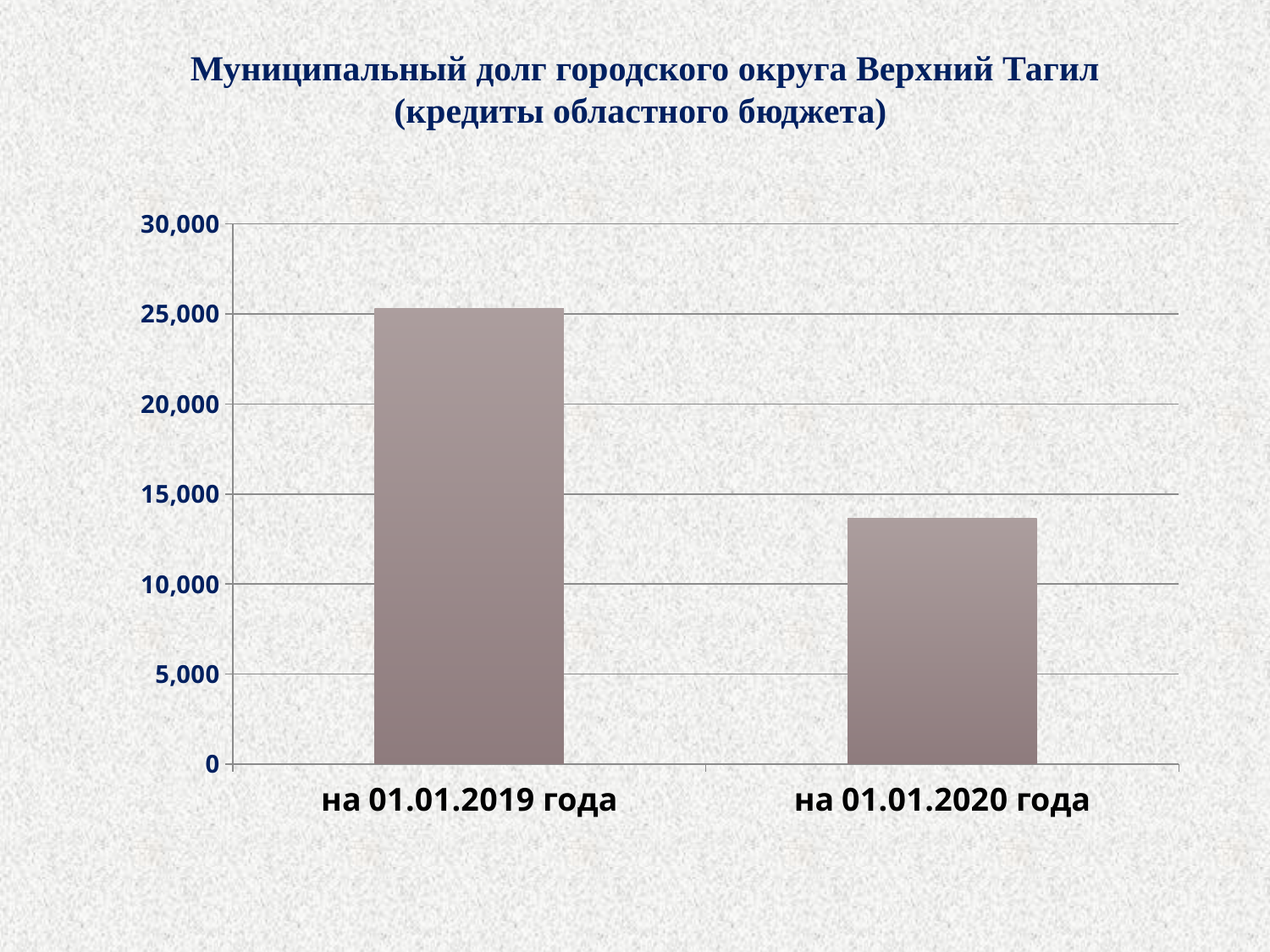
How many categories are shown on the x axis? 2 Is the value for на 01.01.2019 года greater or less than 30,000? less Is the value for на 01.01.2020 года greater or less than 10,000? greater Do the values rise or fall from на 01.01.2019 года to на 01.01.2020 года? fall What is the title of the chart? Муниципальный долг городского округа Верхний Тагил (кредиты областного бюджета) What kind of chart is shown on the slide? bar chart Is the value for на 01.01.2020 года greater or less than 15,000? less Which category has the highest value? на 01.01.2019 года What is the highest value shown on the vertical axis? 30,000 Which is larger, the value for на 01.01.2019 года or the value for на 01.01.2020 года? на 01.01.2019 года Which category has the lowest value? на 01.01.2020 года